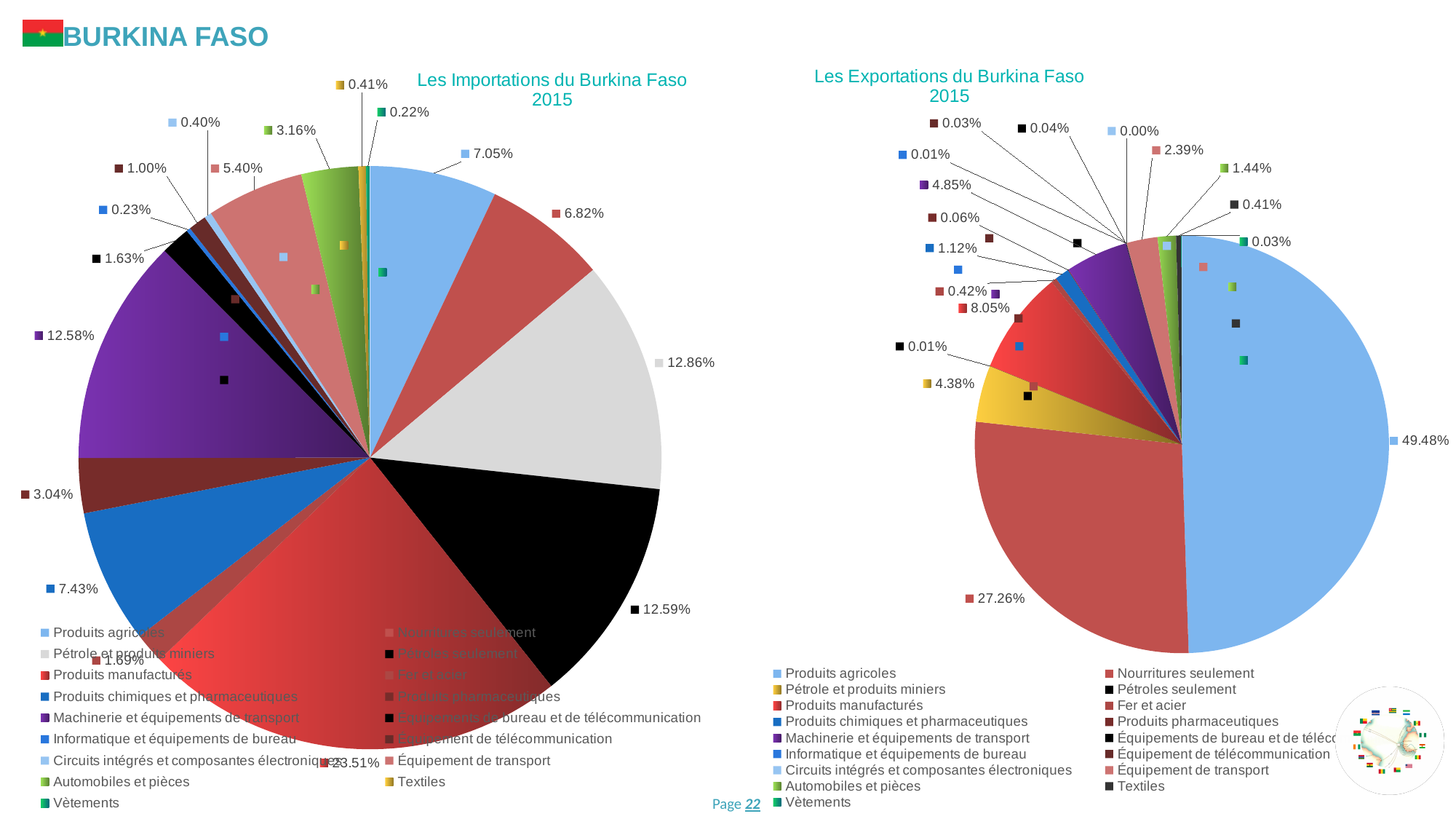
In 'Les Importations du Burkina Faso 2015', what is the largest share shown? 23.51% In 'Les Exportations du Burkina Faso 2015', what is the difference between the shares of Produits agricoles (49.48%) and Nourritures seulement (27.26%)? 22.22% How many categories does the legend of 'Les Exportations du Burkina Faso 2015' list? 17 In 'Les Exportations du Burkina Faso 2015', what is the share of Produits agricoles? 49.48% What kind of chart is 'Les Importations du Burkina Faso 2015'? pie chart In 'Les Importations du Burkina Faso 2015', what is the share of Pétrole et produits miniers? 12.86% What year do both pie charts on the slide refer to? 2015 In 'Les Importations du Burkina Faso 2015', which category has the largest share? Produits manufacturés In 'Les Exportations du Burkina Faso 2015', what is the share of Nourritures seulement? 27.26% In 'Les Exportations du Burkina Faso 2015', which is larger: the share of Produits manufacturés (8.05%) or Machinerie et équipements de transport (4.85%)? Produits manufacturés In 'Les Exportations du Burkina Faso 2015', which category has the largest share? Produits agricoles